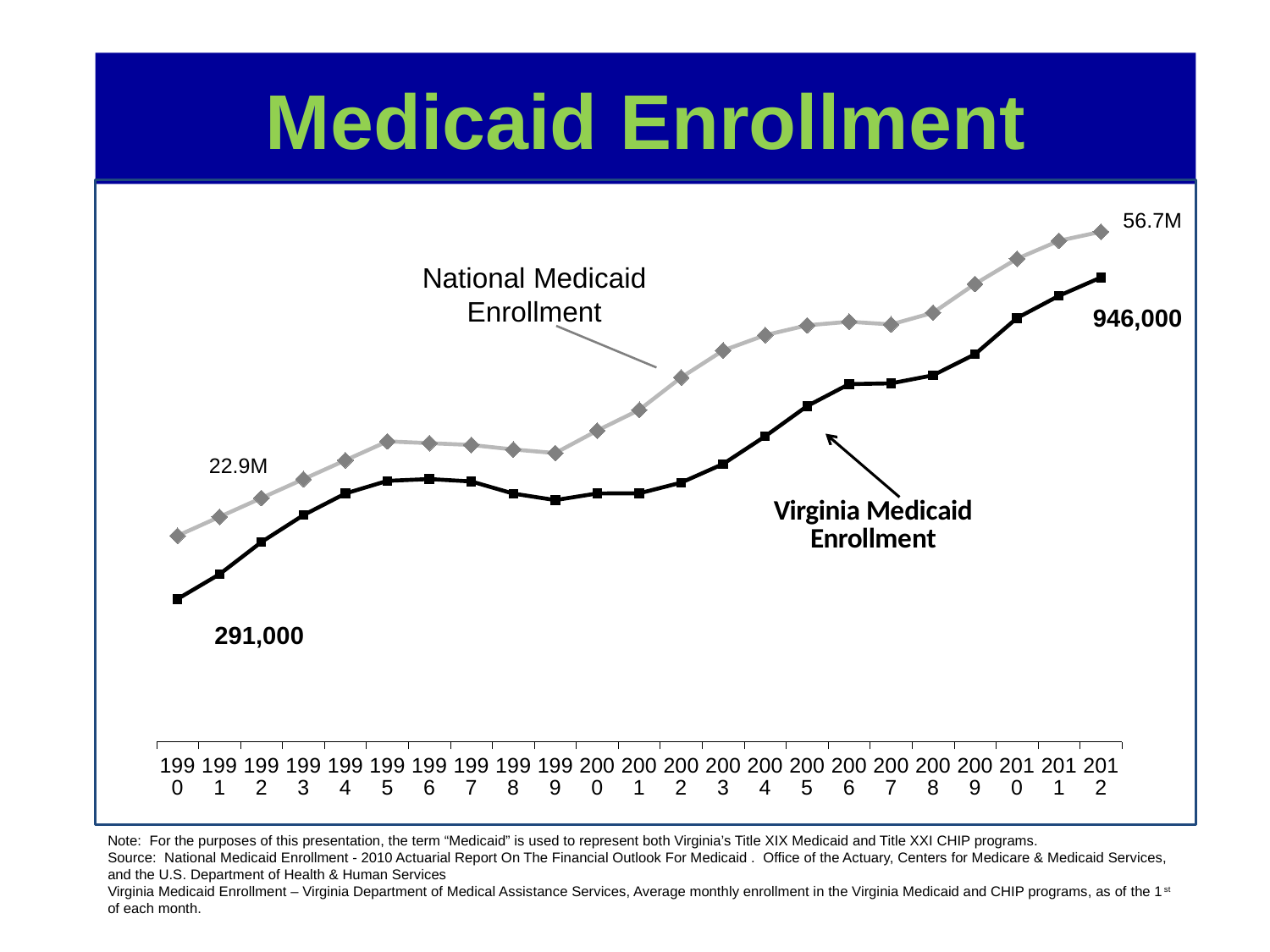
What is the Virginia Medicaid Enrollment value labeled for 2012? 946,000 How many data series are plotted on the chart? 2 What is the first year shown on the x axis? 1990 What is the National Medicaid Enrollment value labeled for 2012? 56.7M Overall, does Virginia Medicaid Enrollment rise or fall from 1990 to 2012? rise How many years are shown along the x axis? 23 What is the National Medicaid Enrollment value labeled for 1990? 22.9M By how much did Virginia Medicaid Enrollment increase from 1990 to 2012, based on the labeled values? 655,000 What is the Virginia Medicaid Enrollment value labeled for 1990? 291,000 What is the title of the slide? Medicaid Enrollment What is the last year shown on the x axis? 2012 What type of chart is shown on the slide? line chart